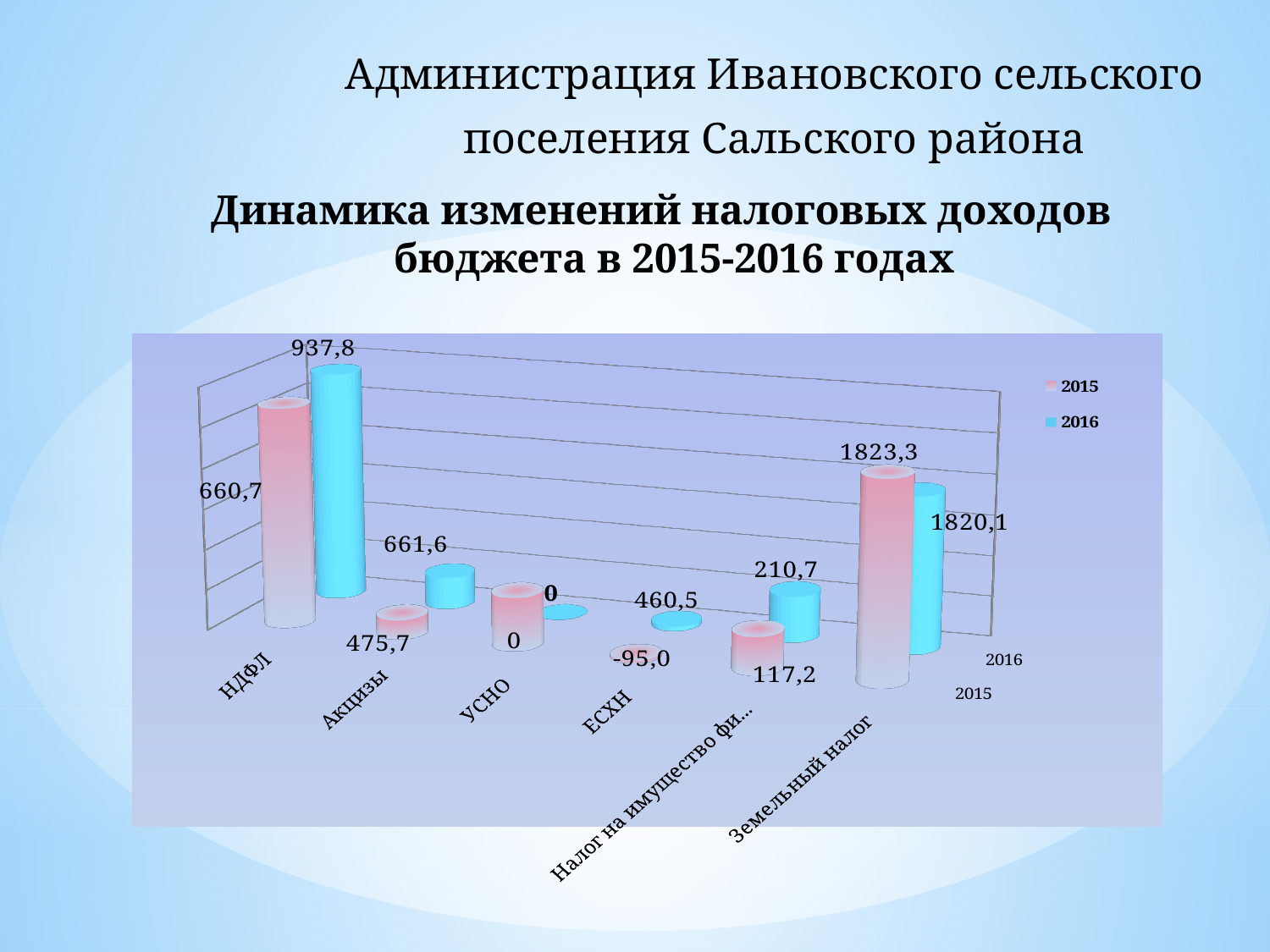
What is the difference between the 2016 and 2015 values for Акцизы? 185,9 How many tax categories are shown on the x axis? 6 What is the 2015 value for НДФЛ? 660,7 Which is larger for Акцизы: the 2015 value or the 2016 value? 2016 By how much did the НДФЛ value increase from 2015 to 2016? 277,1 How many series does the legend list? 2 What is the 2015 value for Земельный налог? 1823,3 What is the 2016 value for Акцизы? 661,6 What is the 2016 value for НДФЛ? 937,8